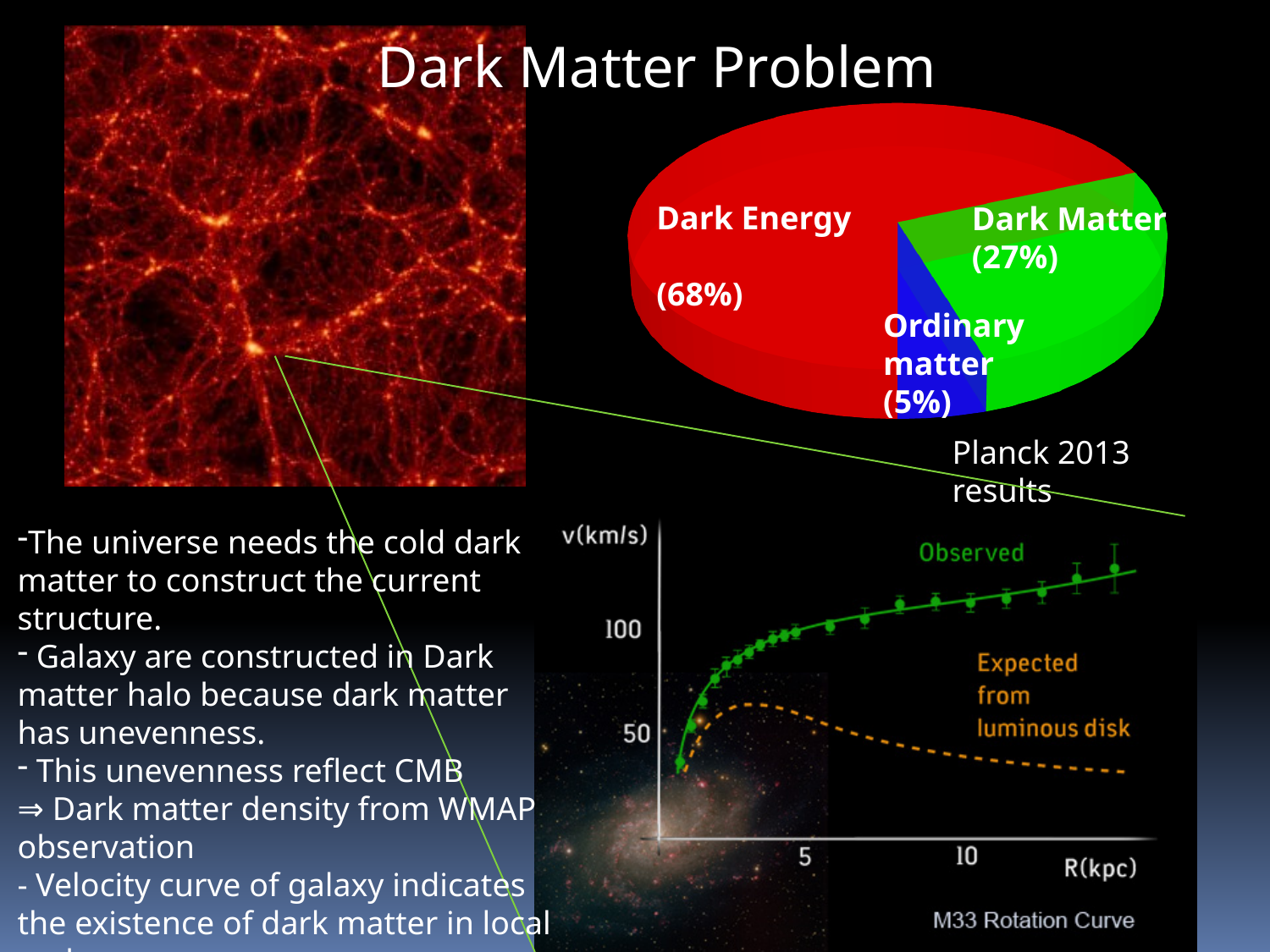
In the pie chart, which component has the largest share? Dark Energy In the pie chart, what percentage is shown for Dark Matter? 27% In the pie chart, which component has the smallest share? Ordinary matter In the pie chart, which is larger, Dark Matter or Ordinary matter? Dark Matter In the pie chart, what colour is the Dark Matter slice? Green In the pie chart, what percentage is shown for Dark Energy? 68% What kind of chart is the chart in the upper right of the slide? Pie chart In the M33 Rotation Curve chart, at R = 10 kpc, which is larger, the Observed curve or the Expected from luminous disk curve? Observed In the pie chart, what percentage is shown for Ordinary matter? 5% In the pie chart, what is the difference in percentage points between Dark Energy and Dark Matter? 41 How many slices does the pie chart have? 3 In the M33 Rotation Curve chart, does the Observed velocity rise or fall as R increases? Rise